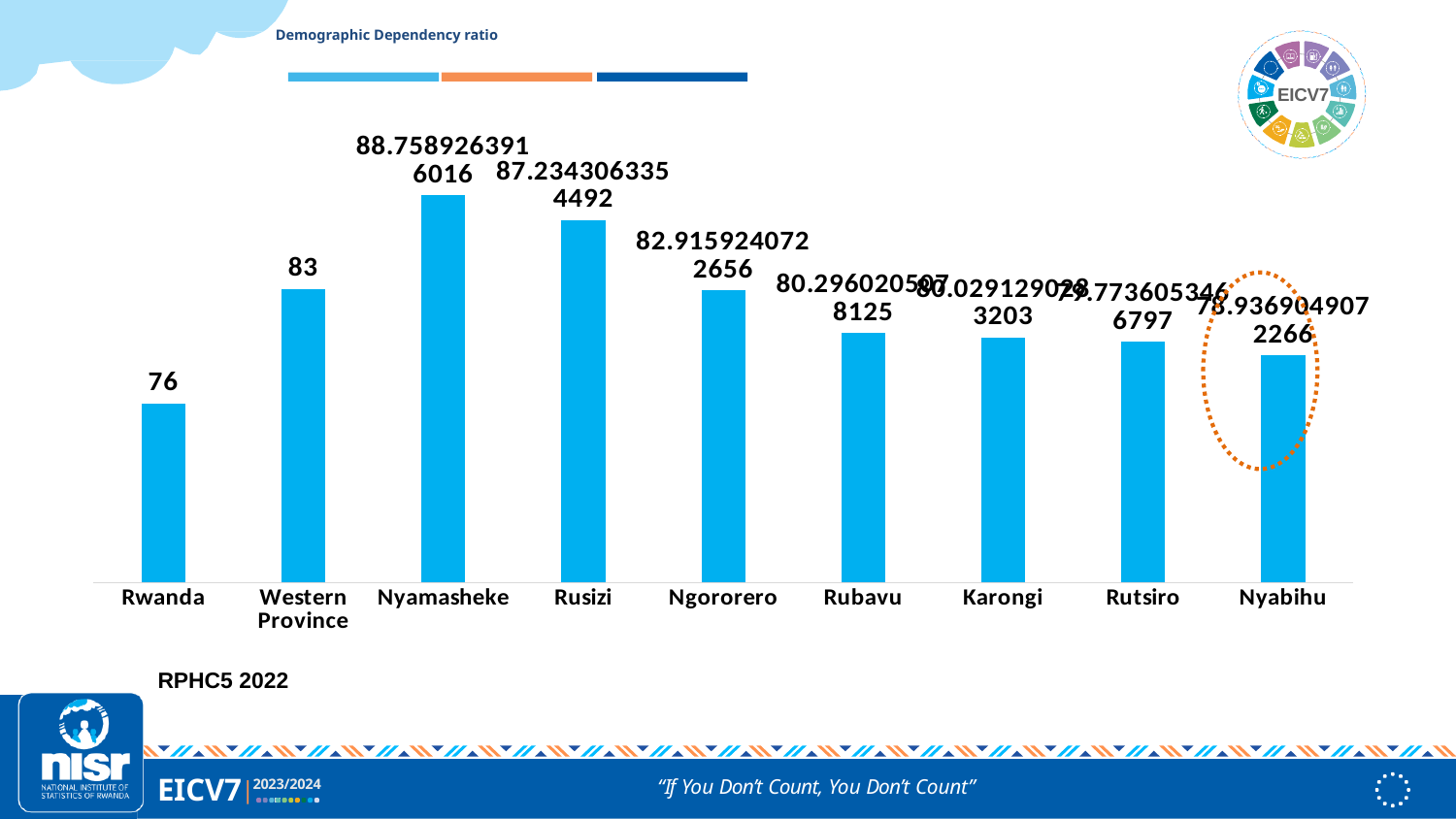
What is the value shown for Rusizi? 87.2343063354492 Which category has the highest value? Nyamasheke What is the difference between the values for Western Province and Rwanda? 7 What is the value for Western Province? 83 Which is larger, the value for Nyamasheke or the value for Rusizi? Nyamasheke Which category's bar is circled with a dotted orange outline? Nyabihu What is the value shown for Nyamasheke? 88.7589263916016 What is the value shown for Ngororero? 82.9159240722656 What is the value for Rwanda? 76 Which category has the lowest value? Rwanda How many categories are shown on the x axis? 9 What kind of chart is shown on the slide? bar chart